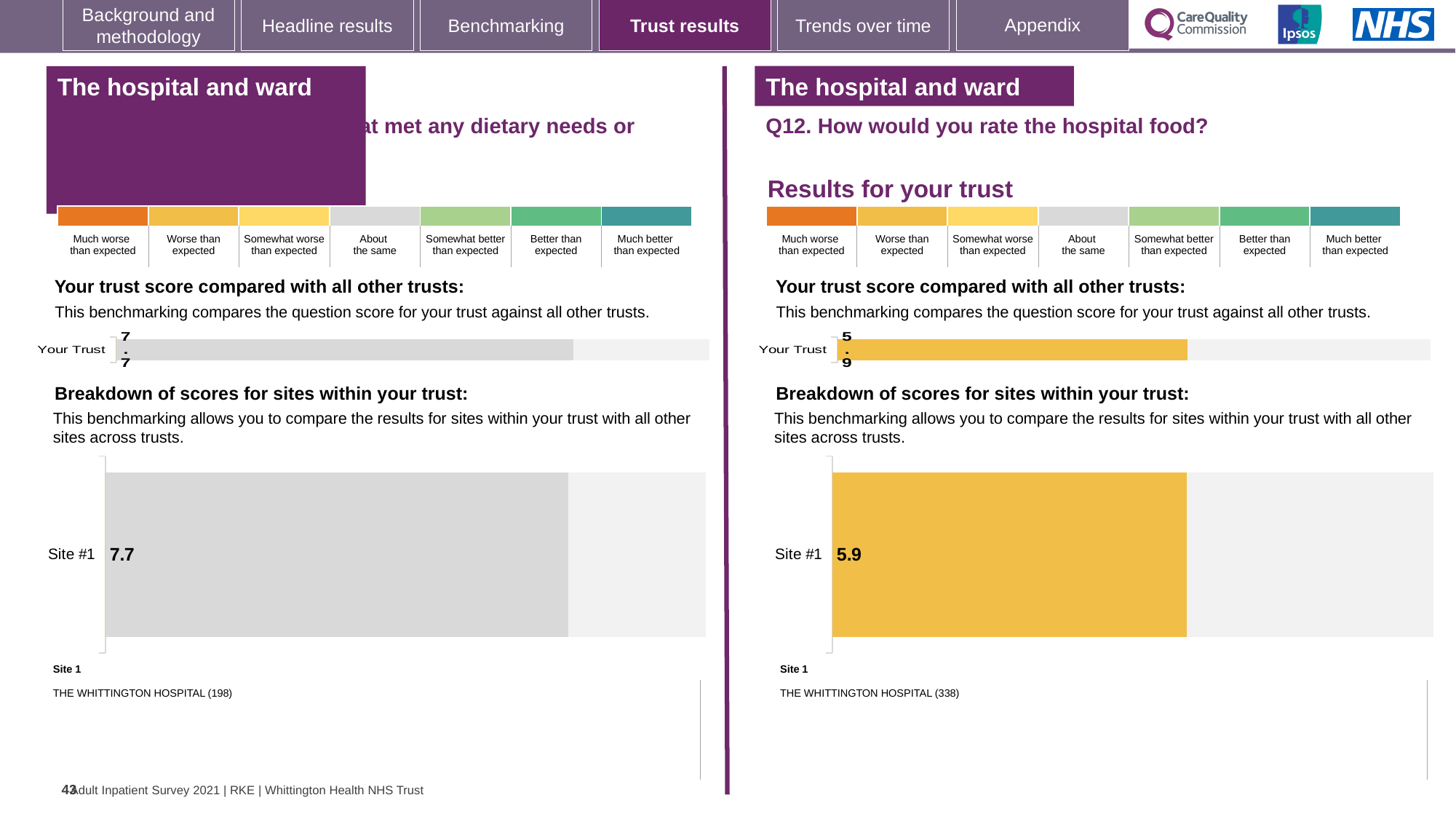
On the breakdown chart in the left half of the slide, what is the score for Site #1? 7.7 How many sites are shown in the left-hand 'Breakdown of scores for sites within your trust' chart? 1 What kind of chart is used to show the Site #1 score on the Q12 hospital food chart? Bar chart On the chart in the left half of the slide, what is the score shown for Your Trust? 7.7 How many sites are shown in the Q12 'Breakdown of scores for sites within your trust' chart? 1 Which Site #1 score is larger: the one on the left-hand chart or the one on the Q12 hospital food chart? The left-hand chart (7.7) On the Q12 hospital food chart, which benchmark category does the yellow colour of the Your Trust bar correspond to? Worse than expected On the Q12 'How would you rate the hospital food?' breakdown chart, what is the score for Site #1? 5.9 On the Q12 'How would you rate the hospital food?' chart, what is the score shown for Your Trust? 5.9 On the Q12 hospital food chart, which hospital is listed as Site 1? THE WHITTINGTON HOSPITAL (338) What is the difference between the Site #1 score on the left-hand chart and the Site #1 score on the Q12 hospital food chart? 1.8